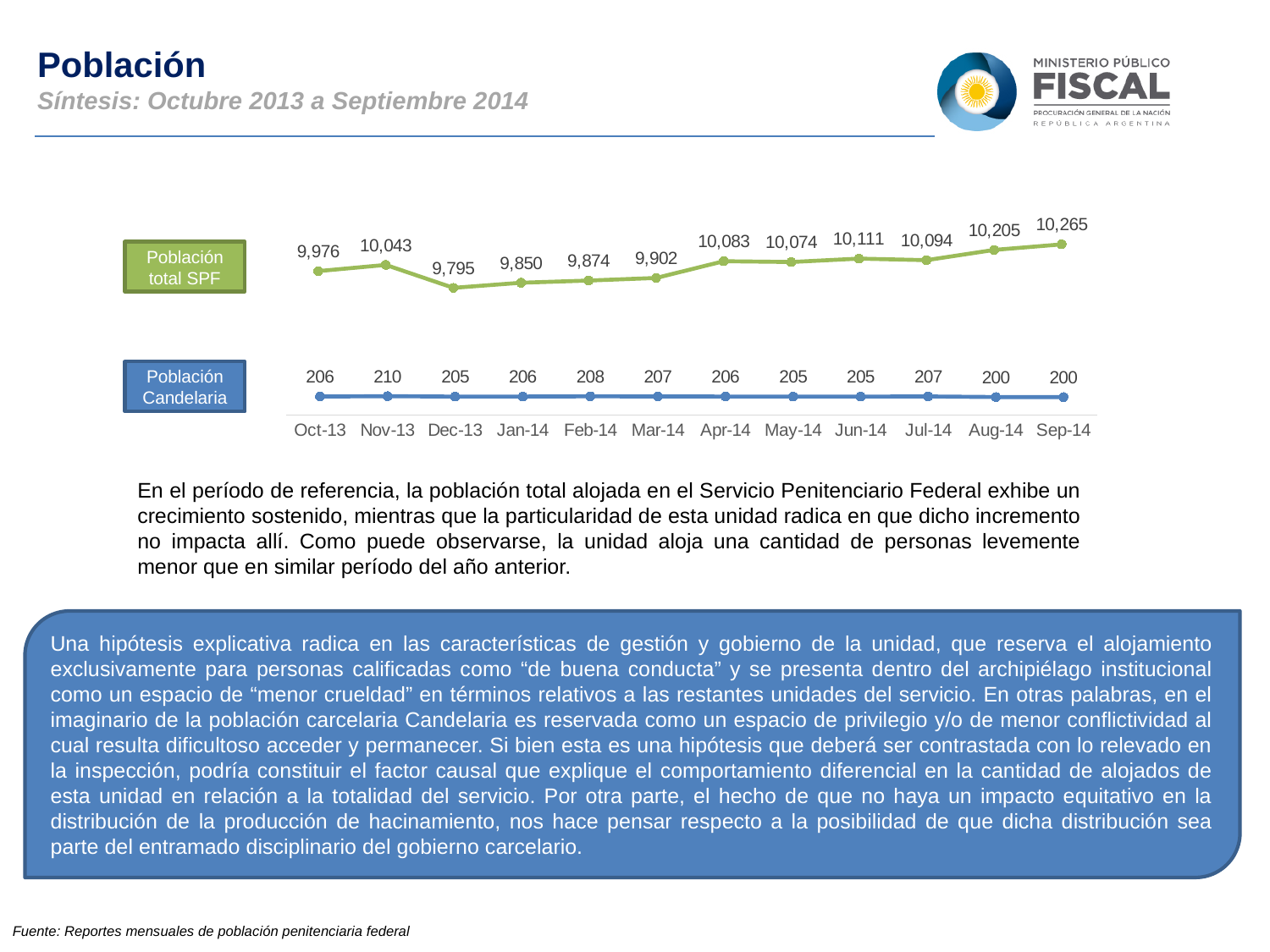
What is the Población total SPF value for Sep-14? 10,265 In which month is the Población total SPF series at its lowest? Dec-13 In which month is the Población Candelaria series at its highest? Nov-13 What is the Población Candelaria value for Nov-13? 210 What is the difference between the Población total SPF values for Sep-14 and Oct-13? 289 In which month is the Población total SPF series at its highest? Sep-14 Which is larger, the Población total SPF value for Nov-13 or for Dec-13? Nov-13 What is the Población total SPF value for Dec-13? 9,795 How many series does the chart show? 2 How many months are plotted on the x axis of the chart? 12 What is the difference between the Población Candelaria values for Nov-13 and Sep-14? 10 What type of chart is shown on the slide? Line chart